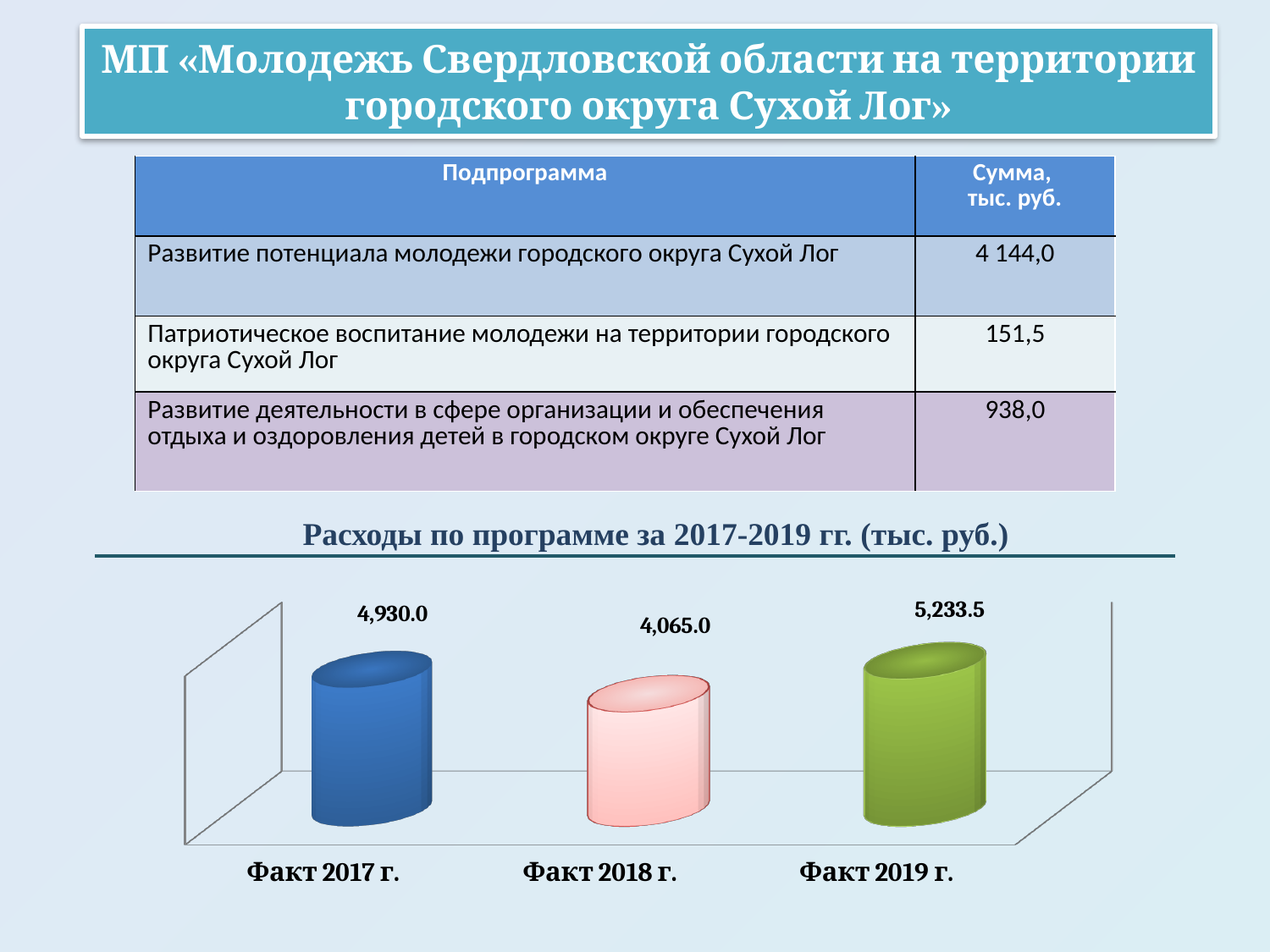
What is the difference between the values for Факт 2017 г. and Факт 2018 г.? 865.0 What is the title of the chart? Расходы по программе за 2017-2019 гг. (тыс. руб.) Which category has the lowest value? Факт 2018 г. Do the values rise or fall from Факт 2018 г. to Факт 2019 г.? Rise How many categories are shown in the chart? 3 What is the value for Факт 2018 г.? 4,065.0 What is the value for Факт 2017 г.? 4,930.0 What is the difference between the values for Факт 2019 г. and Факт 2017 г.? 303.5 What is the value for Факт 2019 г.? 5,233.5 Which category has the highest value? Факт 2019 г. Which is larger, the value for Факт 2017 г. or Факт 2018 г.? Факт 2017 г. What kind of chart is shown on the slide? Bar chart